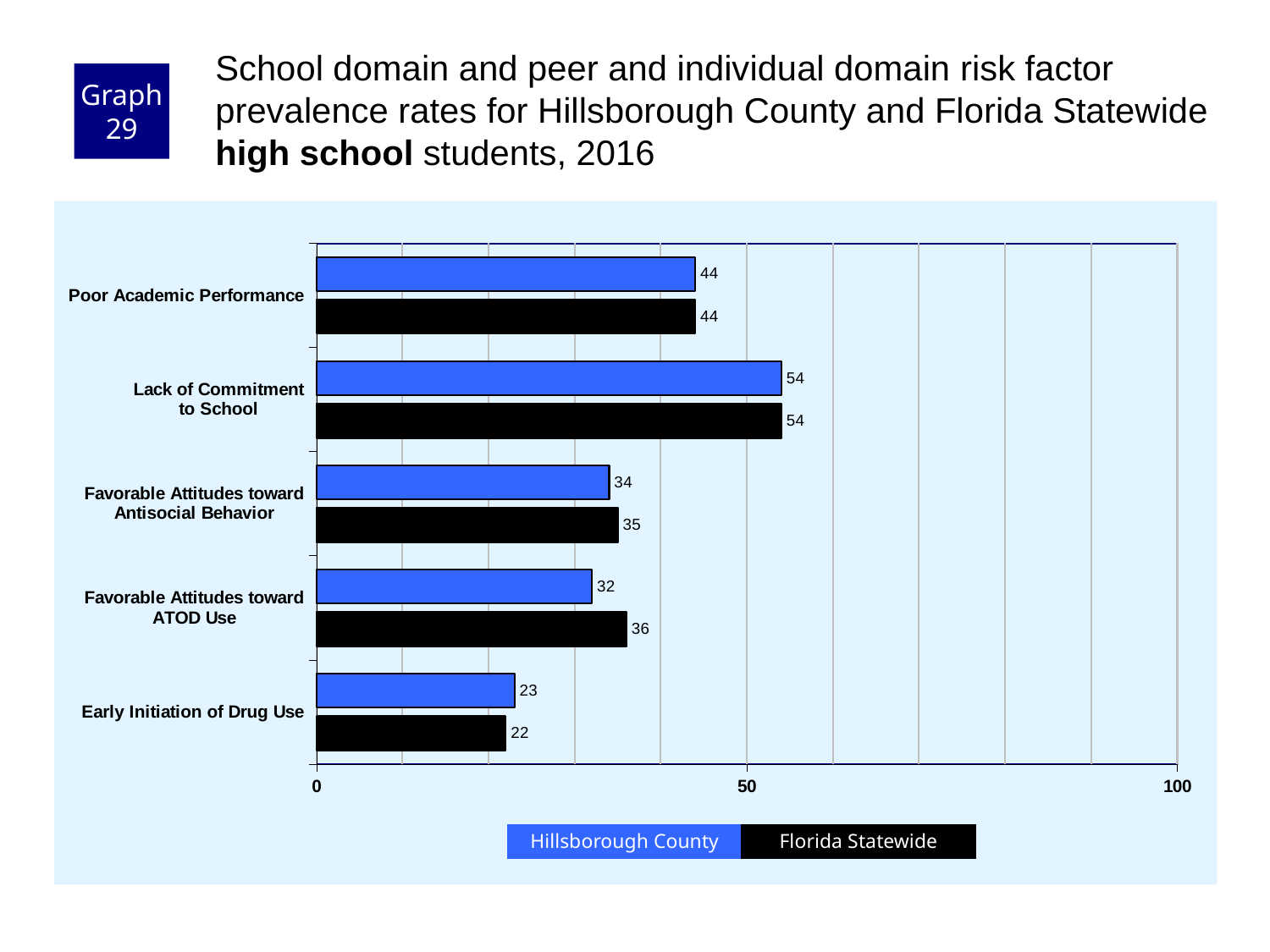
What kind of chart is shown on the slide? bar chart For Favorable Attitudes toward Antisocial Behavior, which is larger: the Hillsborough County value or the Florida Statewide value? Florida Statewide Which colour represents Florida Statewide in the chart? black How many risk factor categories are shown on the chart? 5 Which risk factor has the lowest Florida Statewide value? Early Initiation of Drug Use How many series does the legend list? 2 What is the Florida Statewide value for Favorable Attitudes toward ATOD Use? 36 What is the difference between the Florida Statewide and Hillsborough County values for Favorable Attitudes toward ATOD Use? 4 What is the Hillsborough County value for Early Initiation of Drug Use? 23 Is the Hillsborough County value for Poor Academic Performance greater or less than 50? less Which risk factor has the highest Hillsborough County value? Lack of Commitment to School What is the Hillsborough County value for Lack of Commitment to School? 54